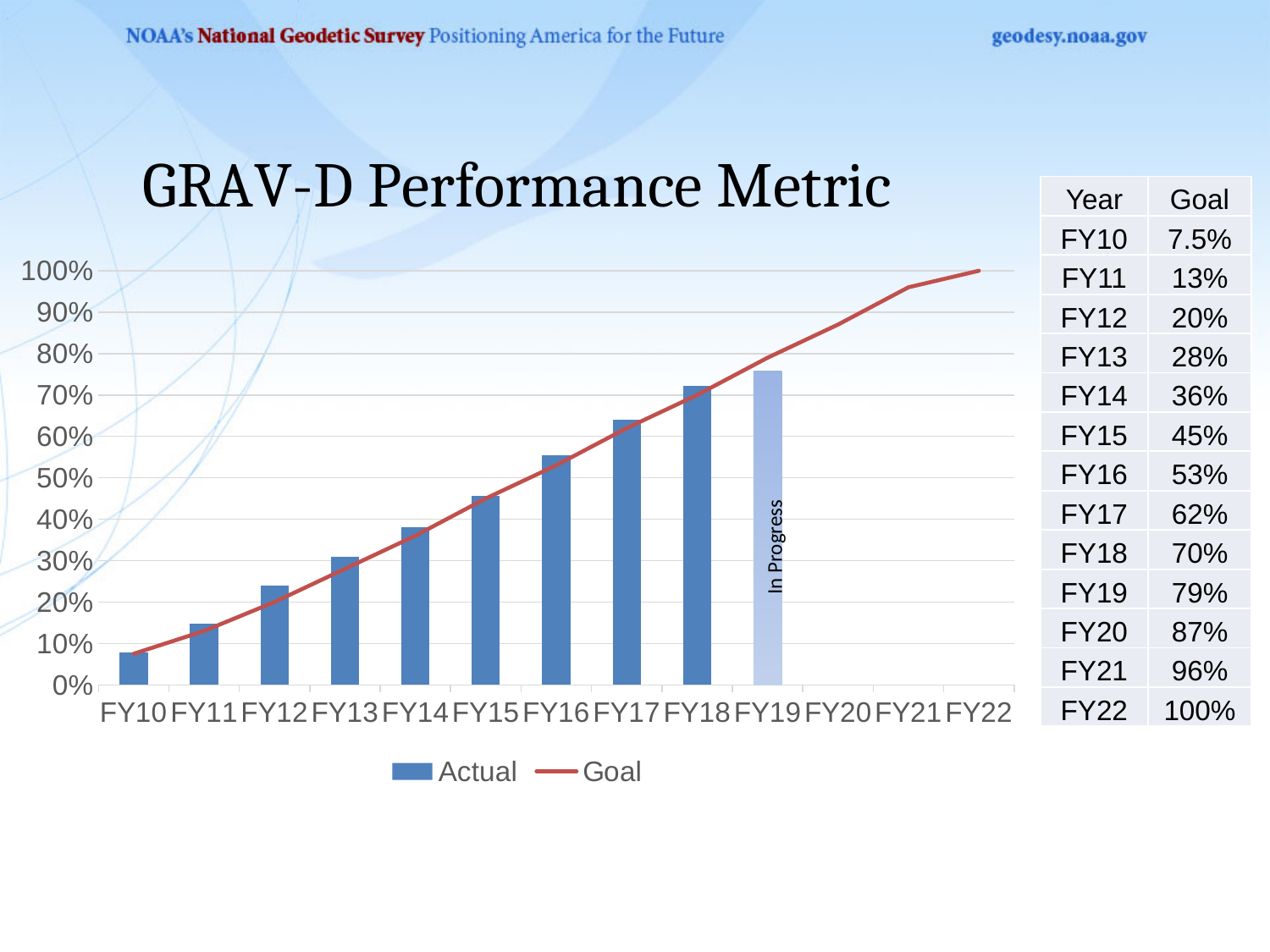
Does the Goal line rise or fall from FY10 to FY22? rises How many series does the legend list? 2 Which fiscal year's bar is labeled "In Progress"? FY19 What kind of chart is shown on the slide? bar chart with a line Is the Actual value for FY18 greater or less than 60%? greater According to the table, what is the Goal value for FY15? 45% How many fiscal years are shown on the x axis? 13 What is the difference between the Goal values for FY18 and FY10? 62.5% Which year has the lowest Goal value? FY10 Is the Actual value for FY12 greater or less than 30%? less According to the table, what is the Goal value for FY22? 100% Which is larger, the Goal value for FY16 or for FY17? FY17